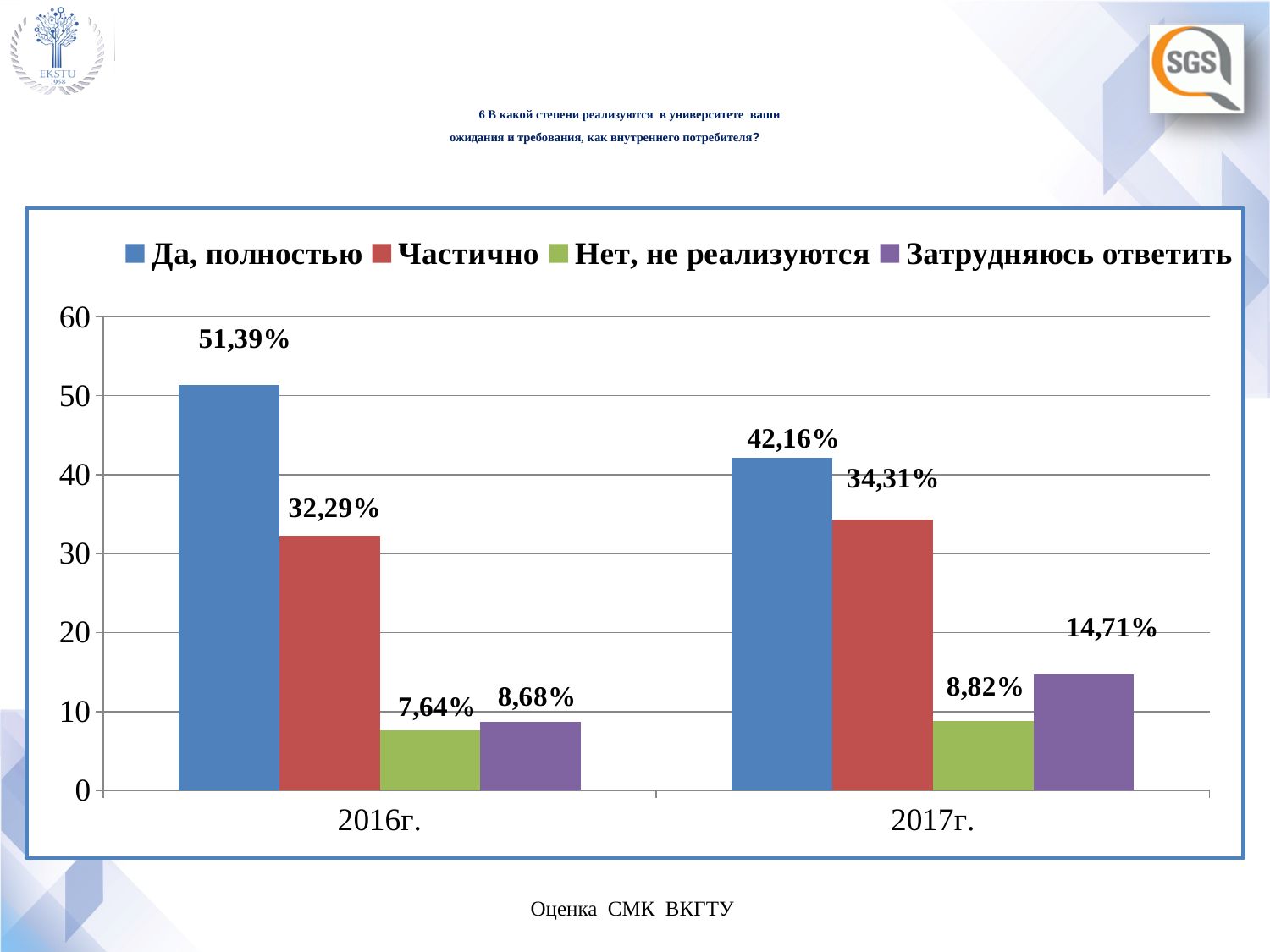
What is the value for "Да, полностью" in 2016г.? 51,39% What is the value for "Частично" in 2017г.? 34,31% How many categories are shown on the x axis? 2 Is the value for "Частично" in 2016г. greater or less than 30? greater Which series has the highest value in 2017г.? Да, полностью What kind of chart is shown on the slide? bar chart Which is larger: "Затрудняюсь ответить" in 2016г. or in 2017г.? 2017г. Which series has the lowest value in 2016г.? Нет, не реализуются How many series does the legend list? 4 What is the difference between the "Да, полностью" values for 2016г. and 2017г.? 9,23% What is the value for "Затрудняюсь ответить" in 2016г.? 8,68% What is the value for "Нет, не реализуются" in 2017г.? 8,82%